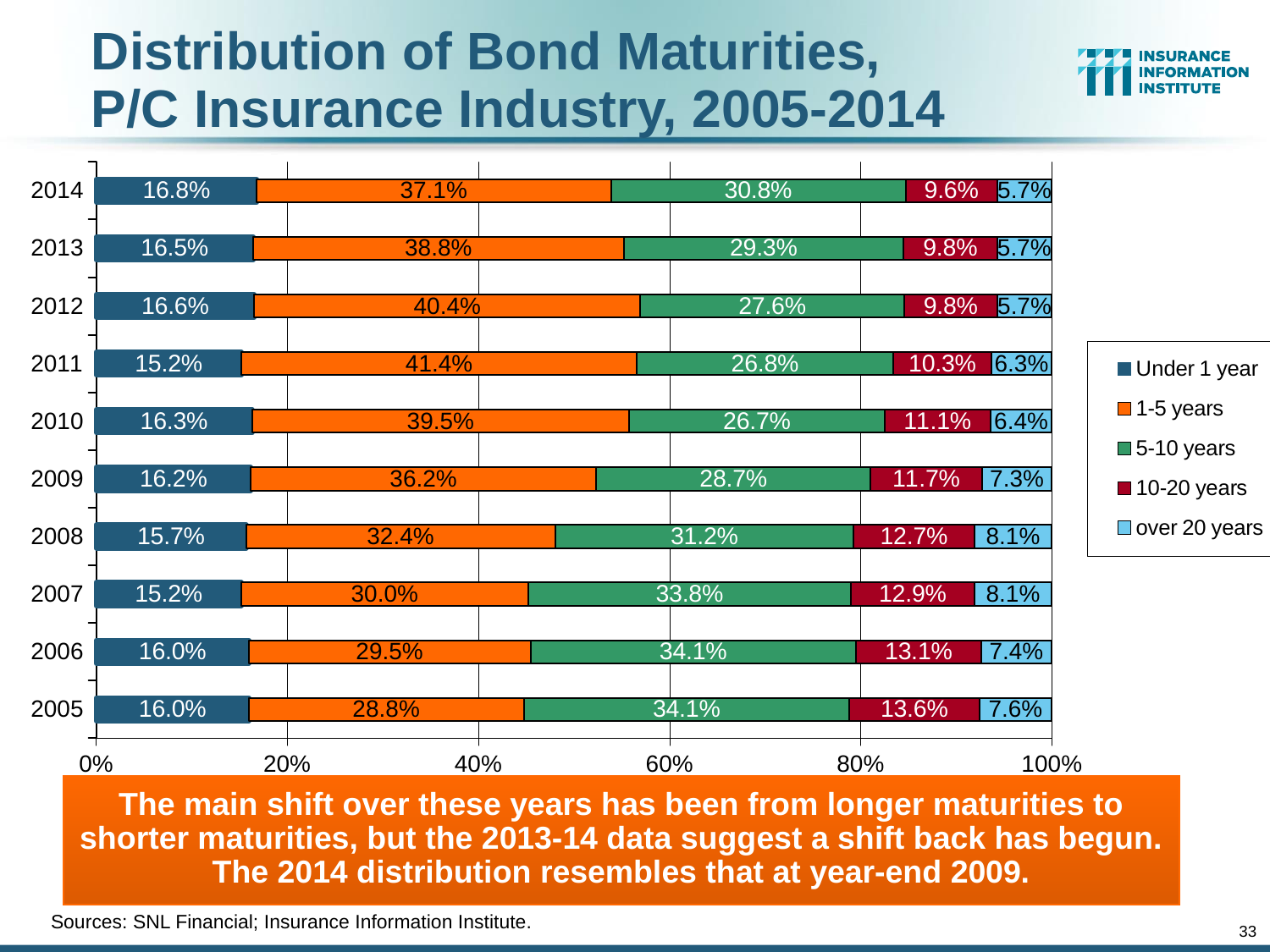
In 2012, which was larger: the 1-5 years share or the 5-10 years share? 1-5 years In which year was the 1-5 years share the lowest? 2005 By how many percentage points did the 1-5 years share in 2014 exceed that in 2005? 8.3 percentage points In which year was the 10-20 years share the highest? 2005 In which year was the 1-5 years share the highest? 2011 Did the share of bonds with 10-20 year maturities rise or fall from 2005 to 2014? Fall What was the share of bonds with maturities over 20 years in 2005? 7.6% How many years are shown on the chart? 10 What share of bonds had 5-10 year maturities in 2007? 33.8% What type of chart is shown on the slide? Stacked bar chart How many maturity categories does the legend list? 5 What share of bonds had maturities of 1-5 years in 2011? 41.4%